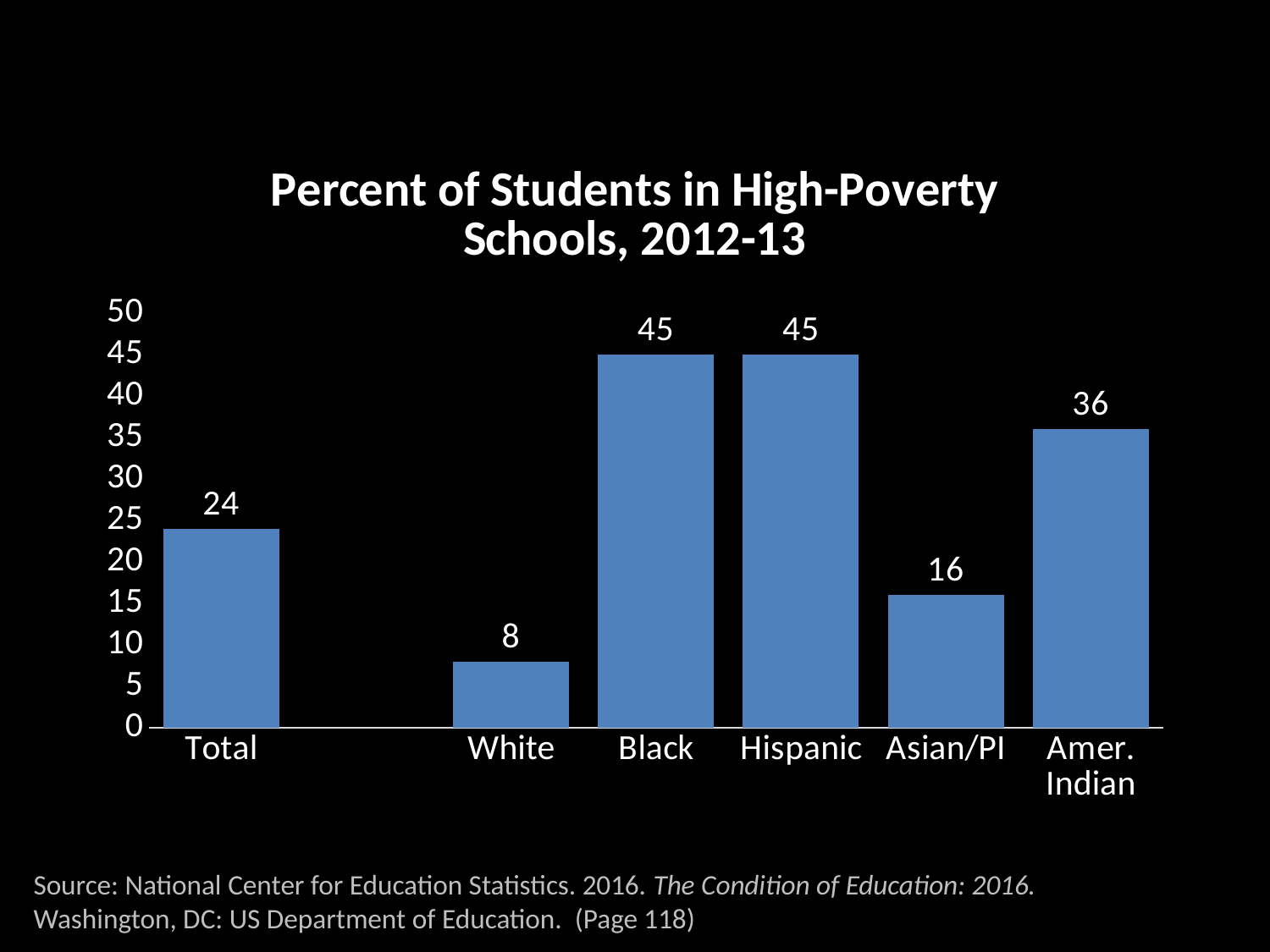
How many categories are shown on the x axis? 6 What is the value for White? 8 What is the difference between the values for Black and White? 37 Which category has the lowest value? White What is the difference between the values for Amer. Indian and Asian/PI? 20 What is the title of the chart? Percent of Students in High-Poverty Schools, 2012-13 What is the value for Asian/PI? 16 What kind of chart is shown on the slide? bar chart What is the value for Amer. Indian? 36 Which is larger, the value for Total or the value for Asian/PI? Total What is the value for Total? 24 Is the value for Hispanic greater or less than 40? greater